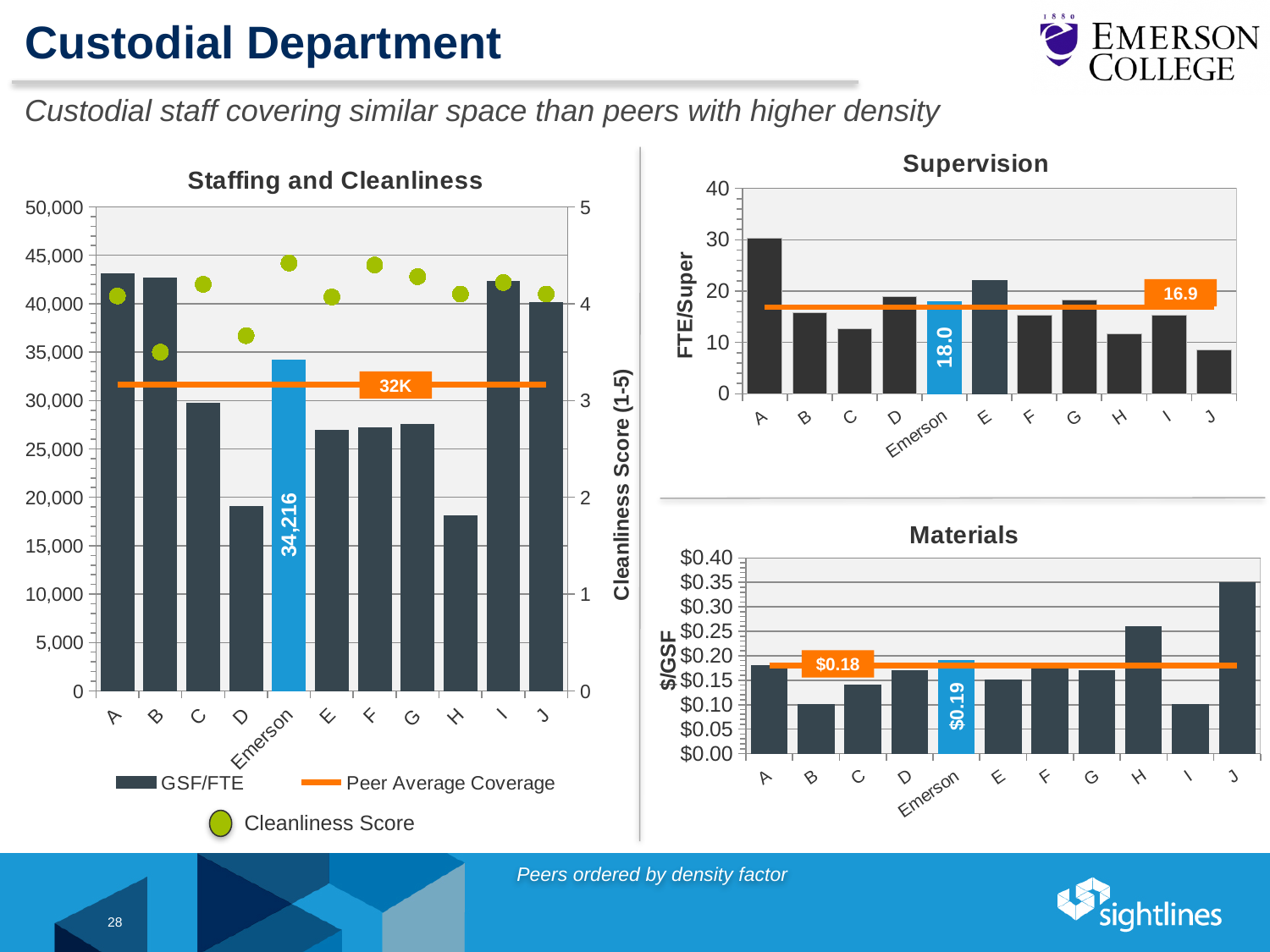
In the Supervision chart, is Emerson's value higher or lower than the peer average? higher How many institutions are shown on the x axis of the Supervision chart? 11 In the Materials chart, which institution has the highest $/GSF? J In the Materials chart, what is the $/GSF value labeled for Emerson? $0.19 In the Supervision chart, which institution has the lowest FTE/Super? J How many series does the legend of the Staffing and Cleanliness chart list? 3 In the Supervision chart, what is the FTE/Super value labeled for Emerson? 18.0 In the Staffing and Cleanliness chart, what is the Peer Average Coverage value shown on the orange line? 32K In the Supervision chart, which institution has the highest FTE/Super? A In the Staffing and Cleanliness chart, is the GSF/FTE bar for H greater or less than 20,000? less In the Supervision chart, what is the peer average value shown on the orange line? 16.9 In the Staffing and Cleanliness chart, what is the GSF/FTE value labeled for Emerson? 34,216